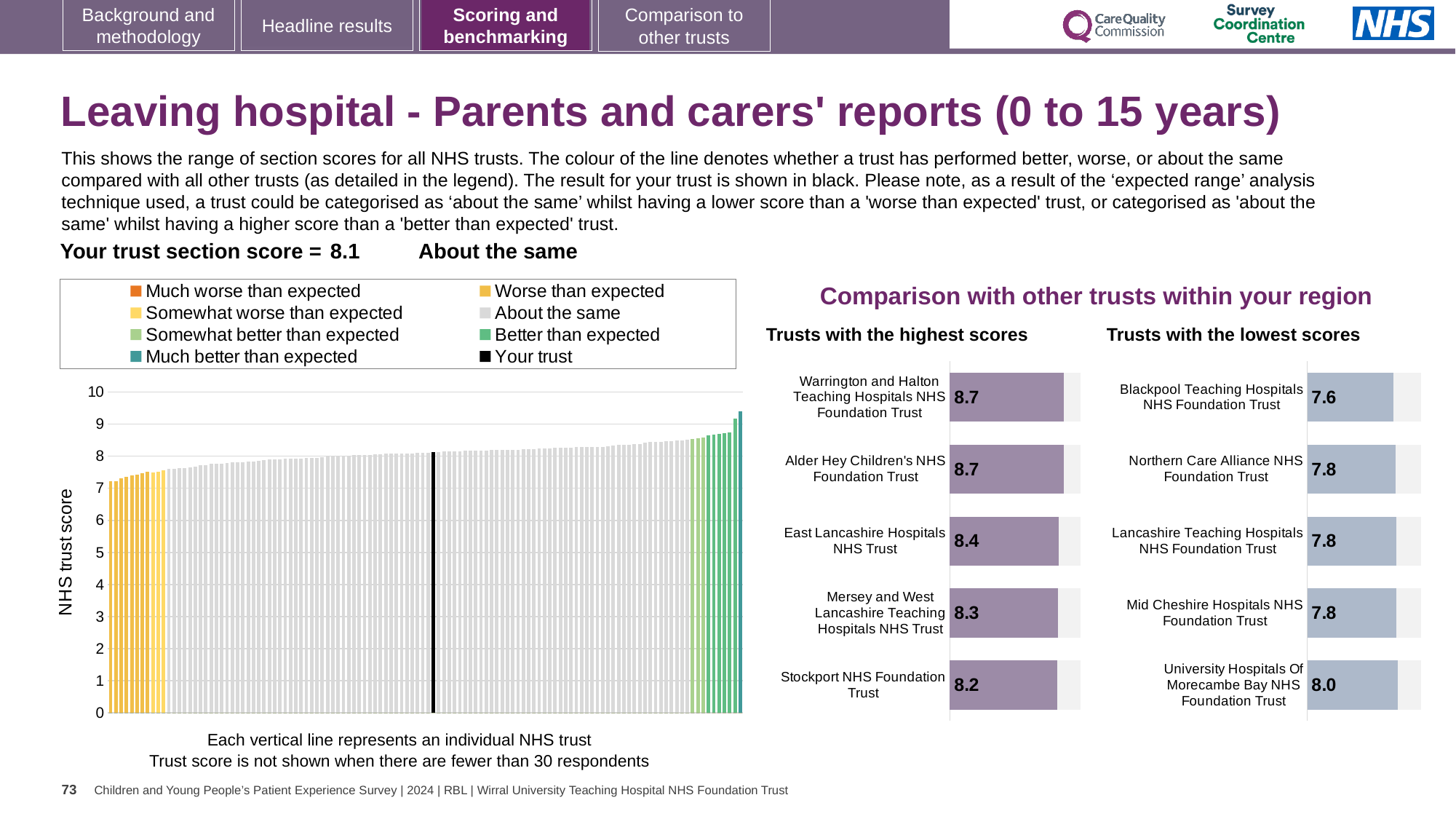
In the 'Trusts with the lowest scores' chart, which trust has the highest score? University Hospitals Of Morecambe Bay NHS Foundation Trust What kind of chart is the large chart on the left showing NHS trust scores? Bar chart In the 'Trusts with the lowest scores' chart, what is the score for Blackpool Teaching Hospitals NHS Foundation Trust? 7.6 In the 'Trusts with the highest scores' chart, what is the score for Stockport NHS Foundation Trust? 8.2 In the 'Trusts with the highest scores' chart, which has the higher score: East Lancashire Hospitals NHS Trust or Mersey and West Lancashire Teaching Hospitals NHS Trust? East Lancashire Hospitals NHS Trust How many trusts are shown in the 'Trusts with the lowest scores' chart? 5 In the 'Trusts with the highest scores' chart, which trust has the lowest score? Stockport NHS Foundation Trust In the 'Trusts with the highest scores' chart, what is the score for East Lancashire Hospitals NHS Trust? 8.4 In the 'Trusts with the lowest scores' chart, what is the difference between the scores of University Hospitals Of Morecambe Bay NHS Foundation Trust and Blackpool Teaching Hospitals NHS Foundation Trust? 0.4 In the 'Trusts with the lowest scores' chart, which trust has the lowest score? Blackpool Teaching Hospitals NHS Foundation Trust In the 'Trusts with the highest scores' chart, what is the difference between the scores of Warrington and Halton Teaching Hospitals NHS Foundation Trust and Stockport NHS Foundation Trust? 0.5 How many entries does the legend of the left-hand chart list? 8